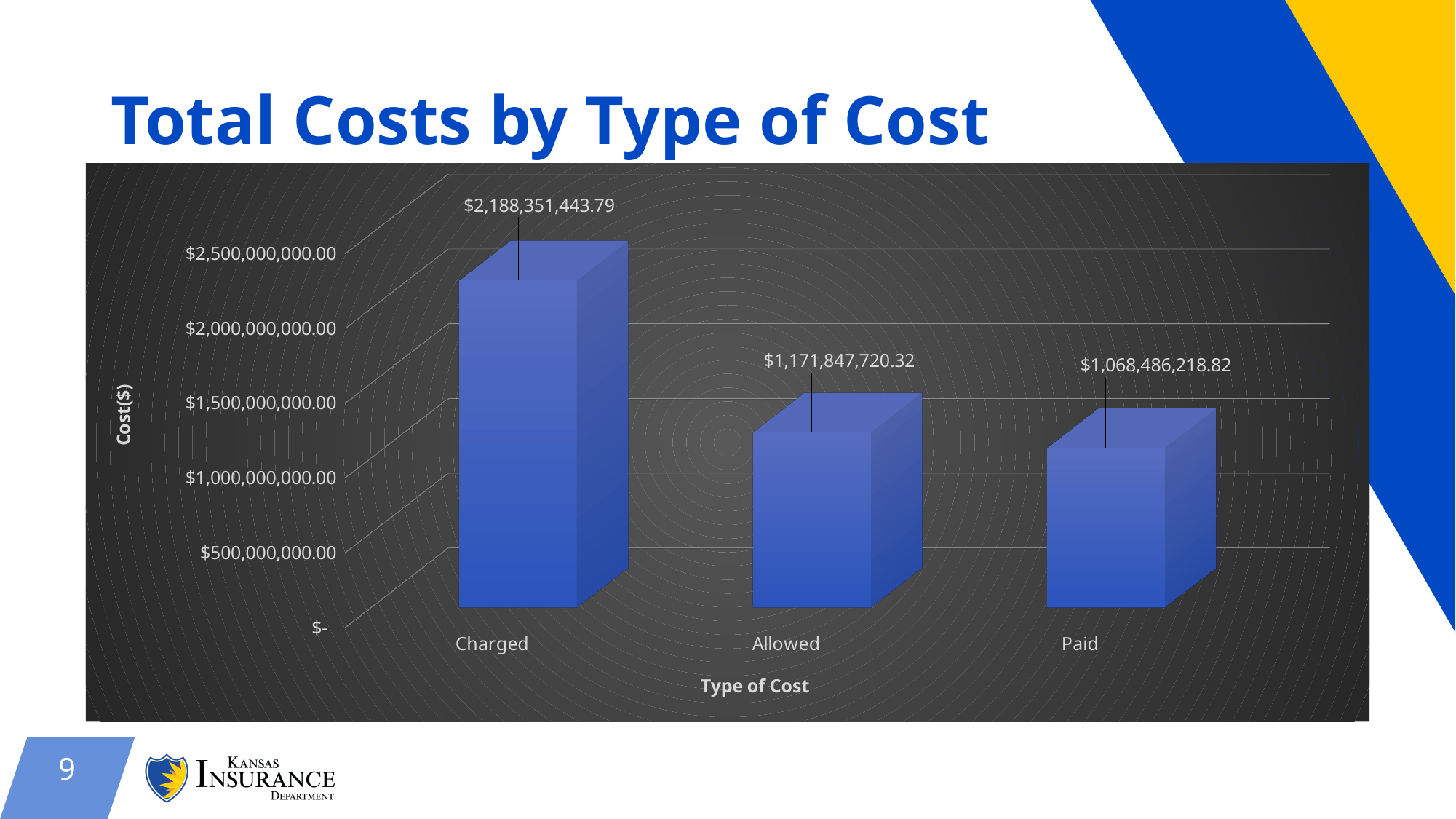
What is the difference between the Charged and Allowed values? $1,016,503,723.47 What kind of chart is shown on the slide? Bar chart Which type of cost has the highest total? Charged Which is larger, the value for Charged or the value for Paid? Charged What is the value for Allowed? $1,171,847,720.32 How many types of cost are shown in the chart? 3 What is the difference between the Allowed and Paid values? $103,361,501.50 Which type of cost has the lowest total? Paid What is the value for Charged? $2,188,351,443.79 Is the value for Charged greater or less than $2,000,000,000.00? greater Do the values rise or fall from Charged to Paid along the x axis? Fall What is the value for Paid? $1,068,486,218.82